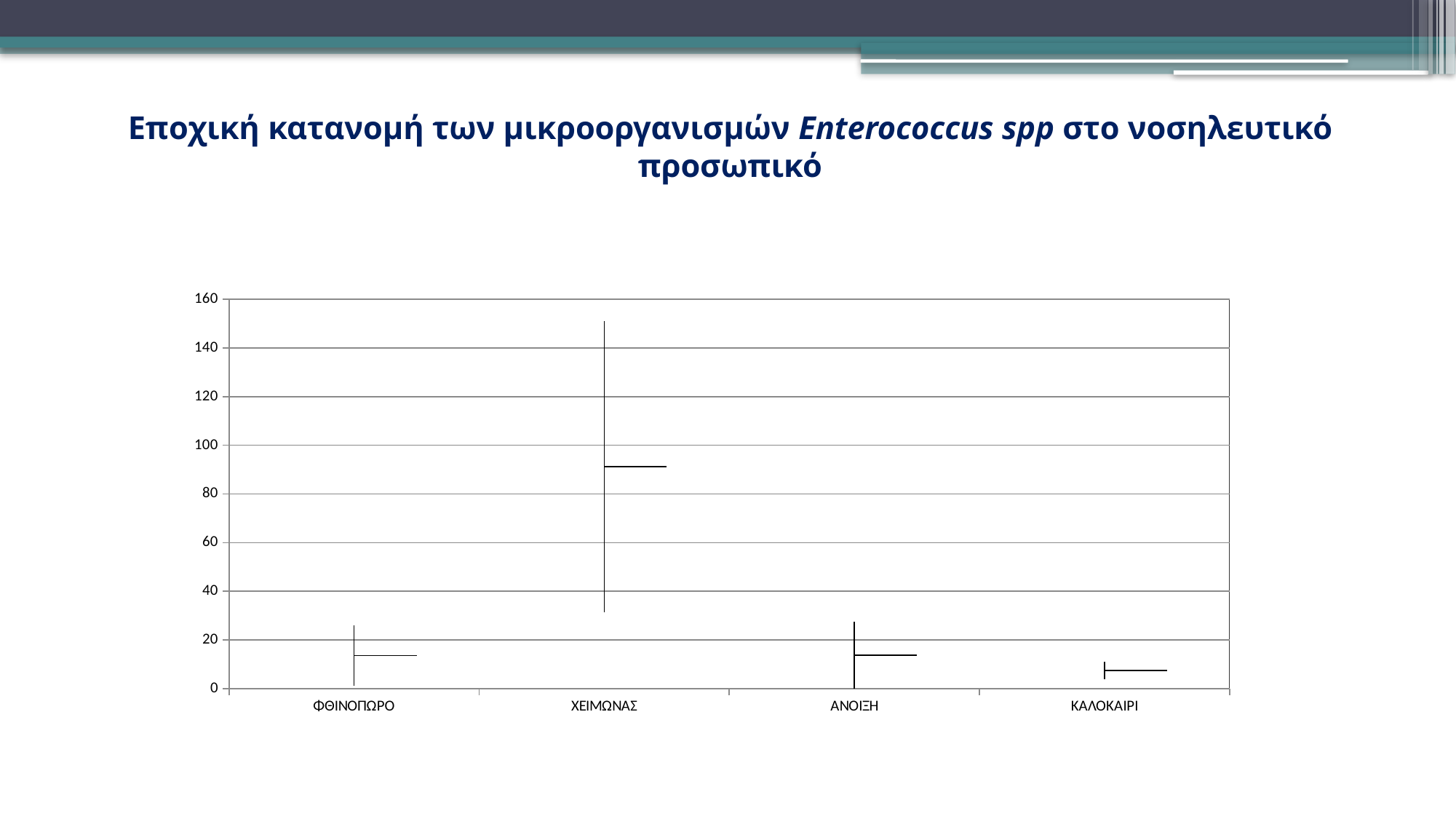
Is the horizontal marker value for ΧΕΙΜΩΝΑΣ greater or less than 100? less Which has a larger horizontal marker value, ΧΕΙΜΩΝΑΣ or ΑΝΟΙΞΗ? ΧΕΙΜΩΝΑΣ Is the horizontal marker value for ΧΕΙΜΩΝΑΣ greater or less than 80? greater Which season has the highest values in the chart? ΧΕΙΜΩΝΑΣ Is the horizontal marker value for ΚΑΛΟΚΑΙΡΙ greater or less than 20? less How many seasons (categories) are shown on the x axis of the chart? 4 Which season has the lowest horizontal marker value in the chart? ΚΑΛΟΚΑΙΡΙ Which microorganism is named in the slide title? Enterococcus spp What is the maximum value shown on the y axis of the chart? 160 Which has a larger horizontal marker value, ΑΝΟΙΞΗ or ΚΑΛΟΚΑΙΡΙ? ΑΝΟΙΞΗ